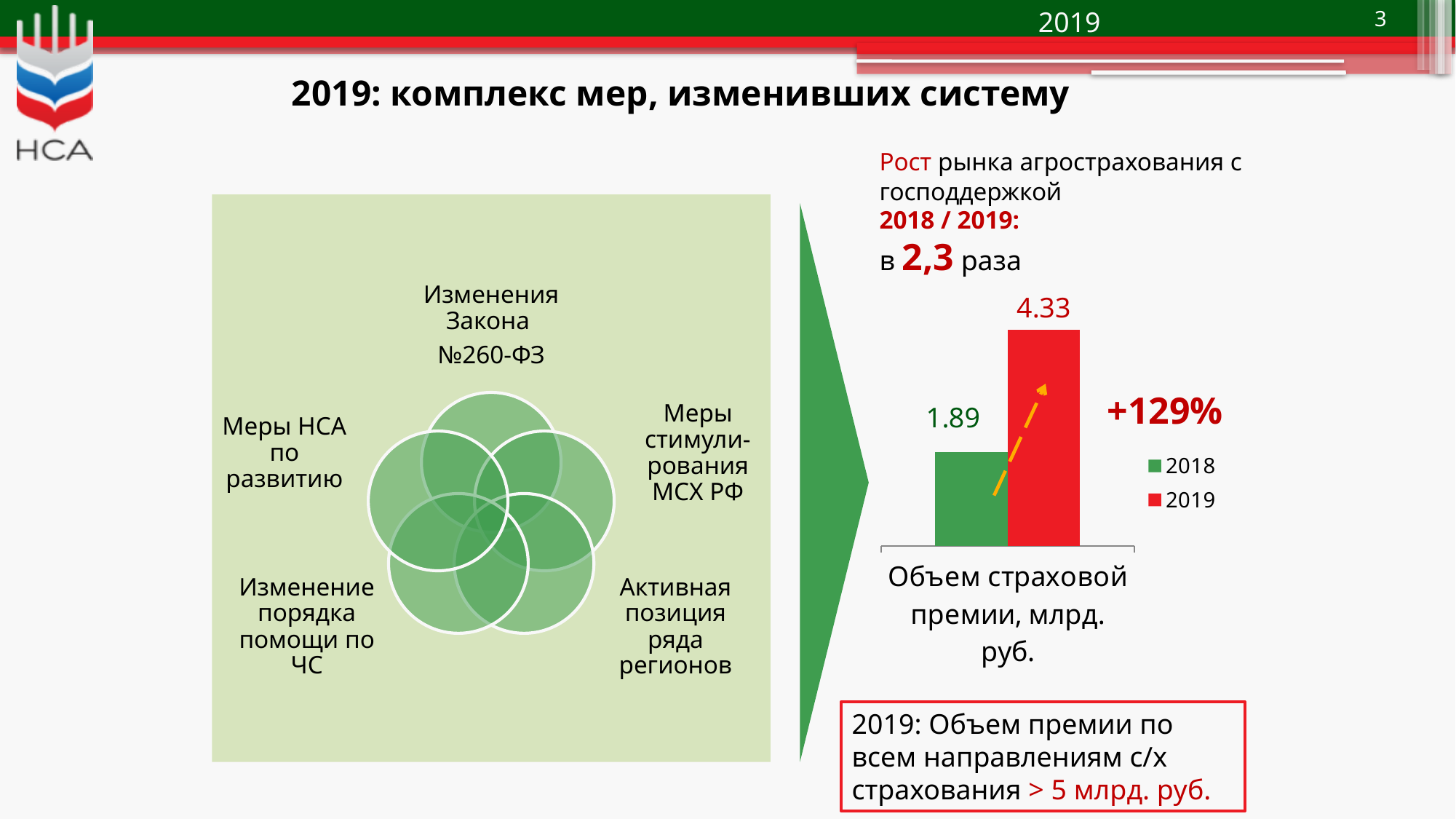
Which year has the higher value in the chart, 2018 or 2019? 2019 What is the value for 2019 in the chart? 4.33 What is the category label shown under the bars in the chart? Объем страховой премии, млрд. руб. What colour is the bar for 2019 in the chart? Red What kind of chart is shown on the slide? Bar chart What is the difference between the 2019 and 2018 values in the chart? 2.44 How many bars are plotted in the chart? 2 What is the value for 2018 in the chart? 1.89 How many series does the chart legend list? 2 Do the values rise or fall from 2018 to 2019 in the chart? Rise Which series has the lowest value in the chart? 2018 Which series has the highest value in the chart? 2019